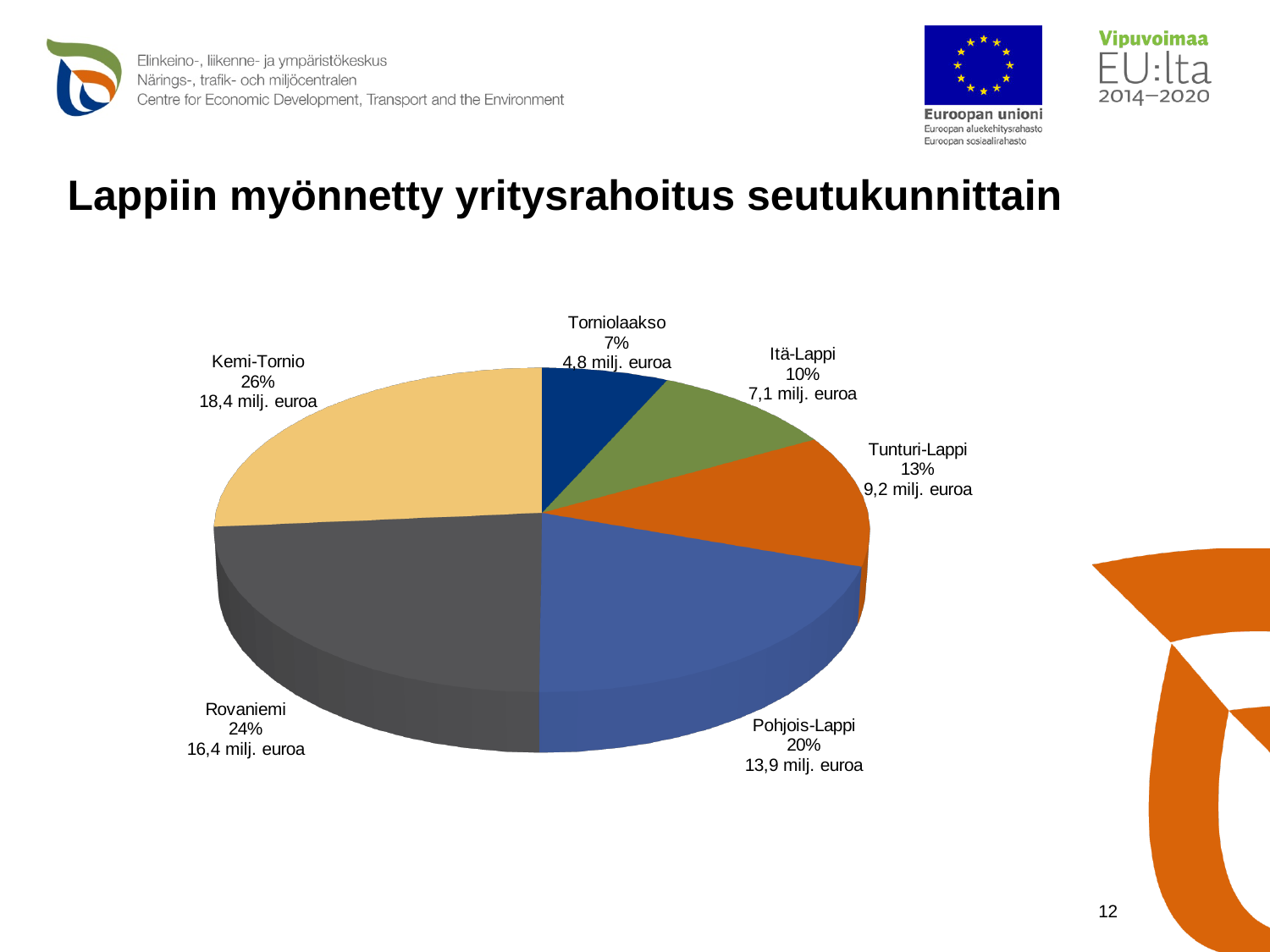
How many slices does the pie chart have? 6 What share of the pie does Pohjois-Lappi represent? 20% What type of chart is shown on the slide? Pie chart Which region has the largest slice of the pie? Kemi-Tornio What is the difference in funding between Kemi-Tornio and Rovaniemi? 2,0 milj. euroa What is the difference in funding between Pohjois-Lappi and Torniolaakso? 9,1 milj. euroa What share of the pie does Kemi-Tornio represent? 26% Which region has the smallest slice of the pie? Torniolaakso What amount in euros is shown for Rovaniemi? 16,4 milj. euroa What amount in euros is shown for Tunturi-Lappi? 9,2 milj. euroa What is the title of the chart on the slide? Lappiin myönnetty yritysrahoitus seutukunnittain Which region received more funding, Itä-Lappi or Tunturi-Lappi? Tunturi-Lappi